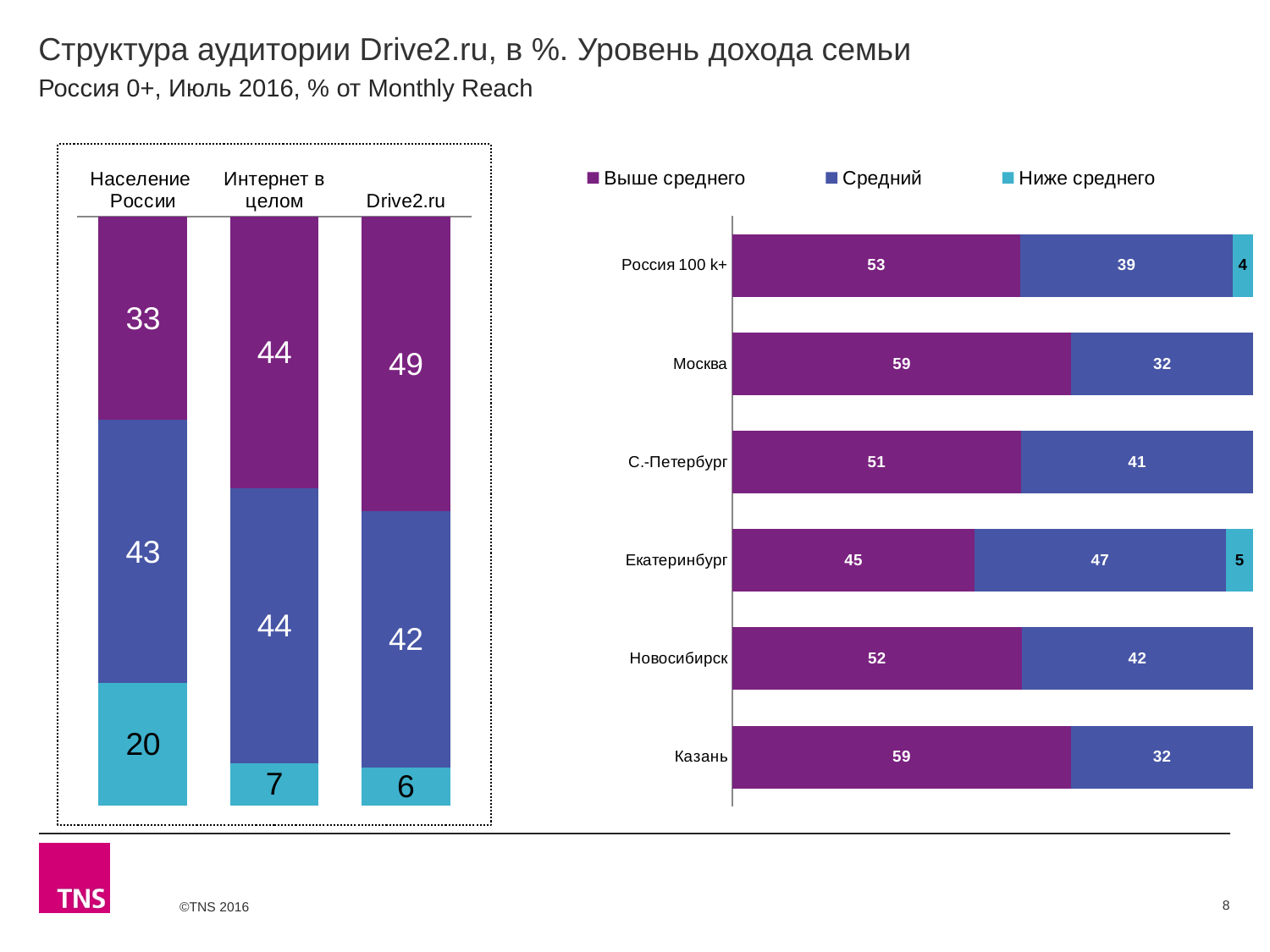
In the left chart, what is the total of the stacked bar for Drive2.ru? 97 In the right chart, what is the difference between the 'Средний' values for С.-Петербург and Казань? 9 In the right chart, which city has the lowest 'Выше среднего' value? Екатеринбург In the left chart, what is the 'Выше среднего' value for Drive2.ru? 49 In the right chart, what is the 'Ниже среднего' value for Россия 100 k+? 4 In the left chart, what is the difference between the 'Выше среднего' values for Drive2.ru and Население России? 16 In the left chart, what is the 'Ниже среднего' value for Население России? 20 In the right chart, what is the 'Средний' value for Екатеринбург? 47 In the right chart, is the 'Выше среднего' value larger for Москва or for С.-Петербург? Москва How many series does the legend list? 3 In the left chart, which category has the lowest 'Ниже среднего' value? Drive2.ru How many categories are shown in the right chart? 6